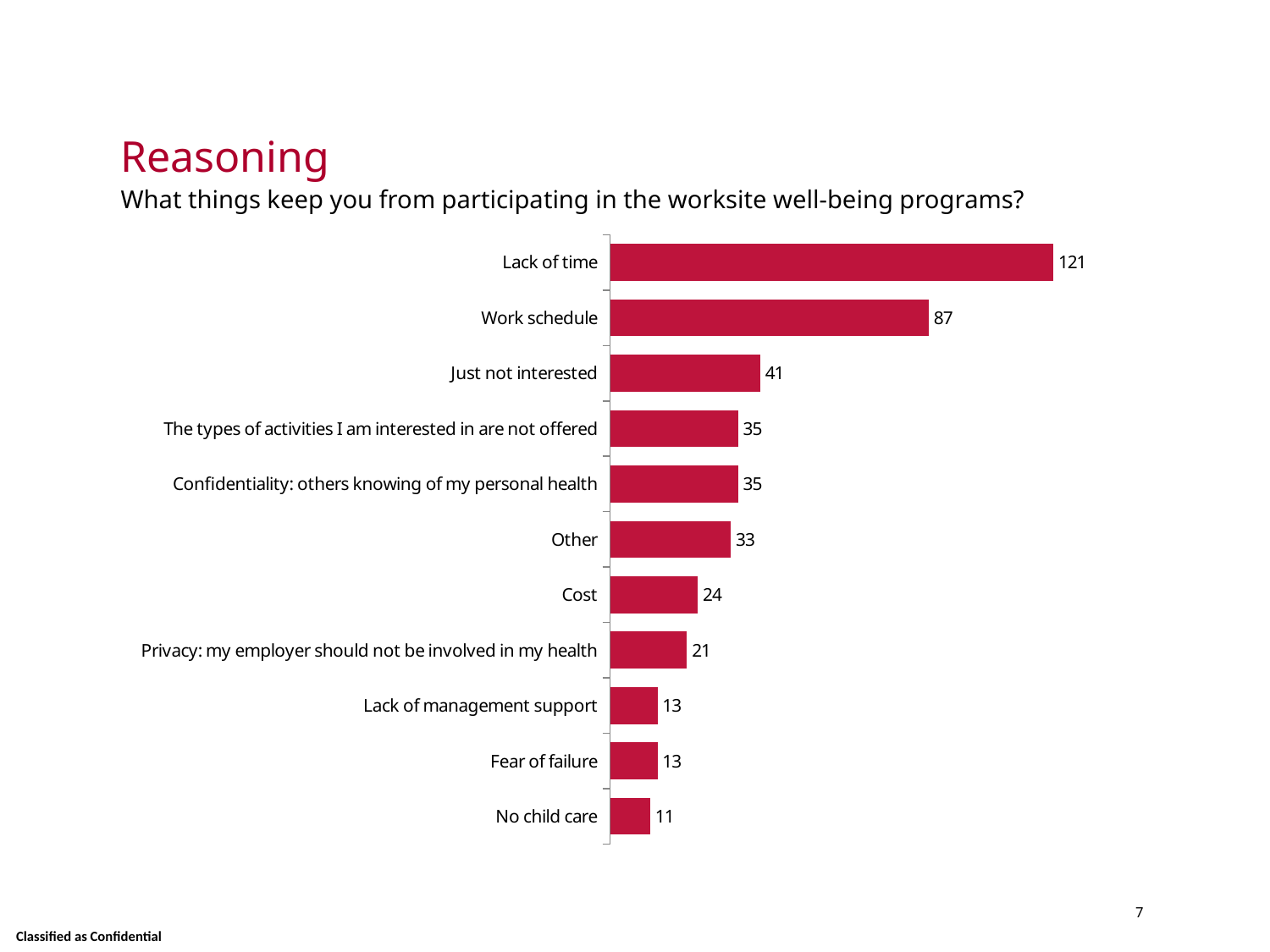
What is the value for Work schedule? 87 Which is larger, the value for Cost or the value for Other? Other What is the value for Privacy: my employer should not be involved in my health? 21 What is the difference between the values for Lack of time and Work schedule? 34 What question does the chart answer, as stated in the subtitle? What things keep you from participating in the worksite well-being programs? What is the difference between the values for Just not interested and Other? 8 How many categories are shown in the chart? 11 What kind of chart is shown on the slide? Bar chart What is the value for Lack of time? 121 Which category has the highest value? Lack of time Which category has the lowest value? No child care What is the value for Cost? 24